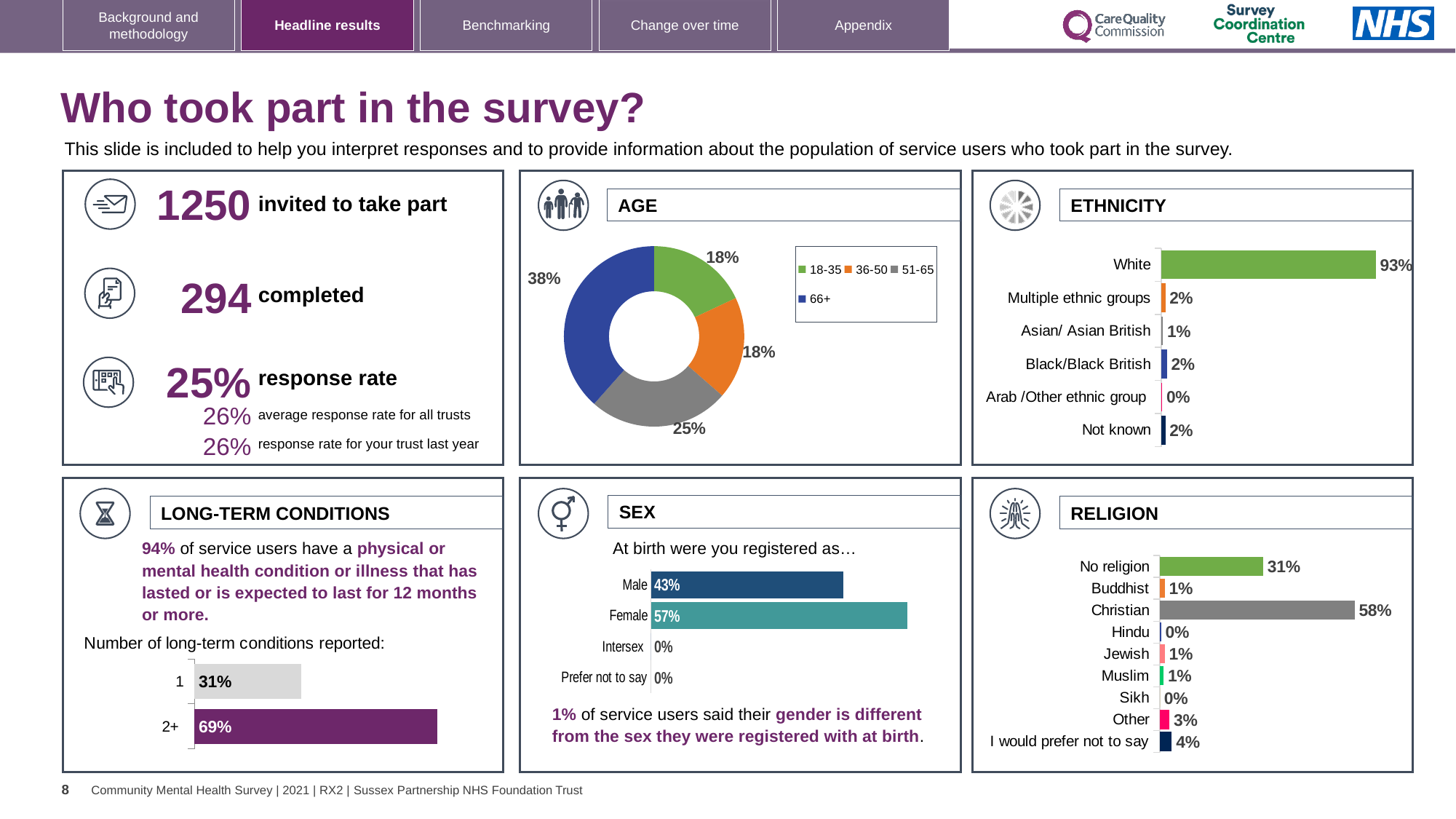
How many categories are shown in the RELIGION chart? 9 In the LONG-TERM CONDITIONS chart, what is the difference between the value for 2+ and the value for 1? 38% In the RELIGION chart, which category has the highest value? Christian In the ETHNICITY chart, which category has the lowest value? Arab /Other ethnic group In the AGE chart, what percentage of respondents were aged 66+? 38% In the SEX chart, which is larger, Male or Female? Female In the AGE chart, which age group has the largest share? 66+ What kind of chart is the AGE chart? Donut (pie) chart In the SEX chart, what is the value for Male? 43% How many series does the legend of the AGE chart list? 4 How many categories are shown in the ETHNICITY chart? 6 In the ETHNICITY chart, what is the value for White? 93%